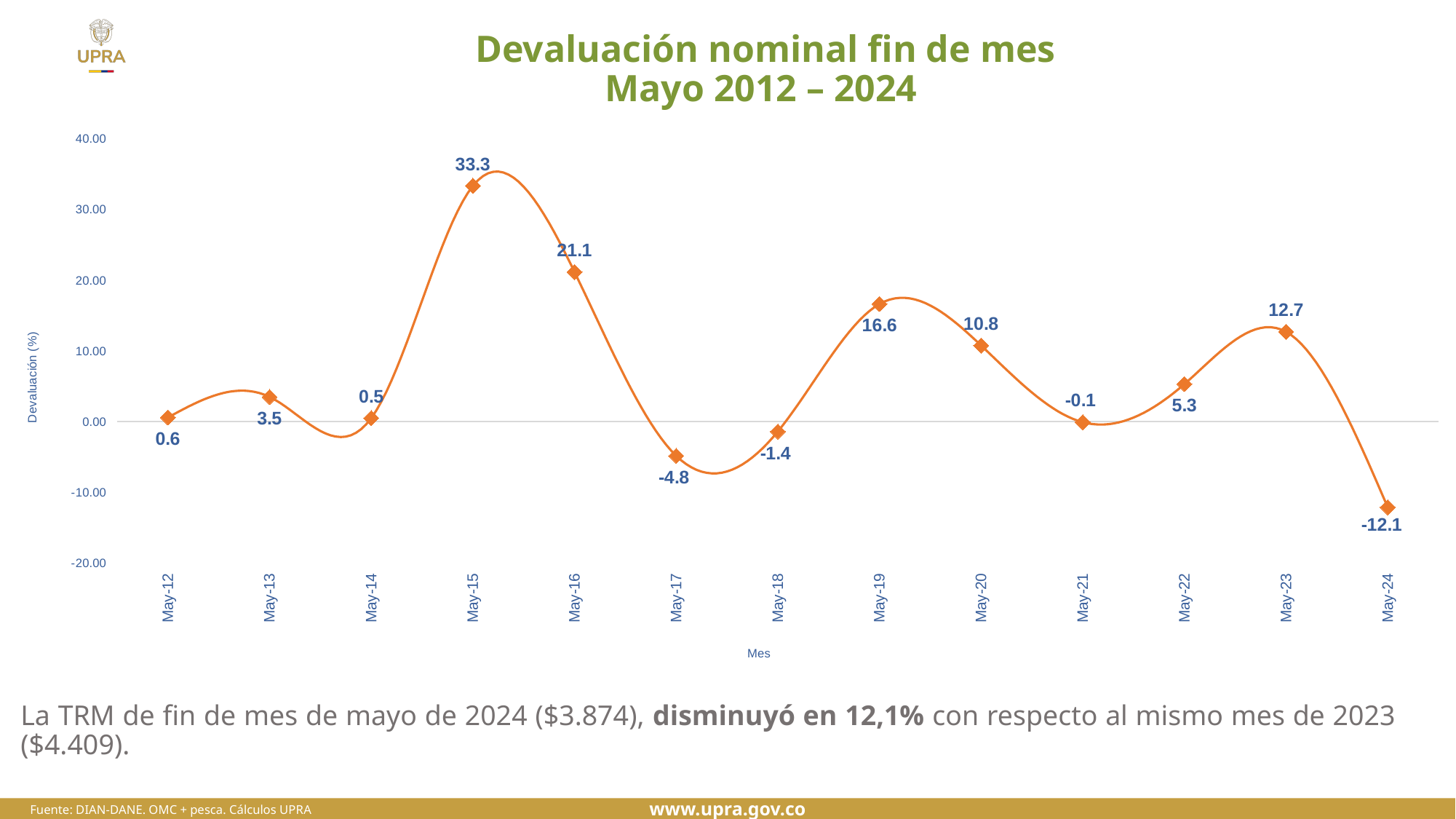
What is the value for May-19? 16.6 Which is larger, the value for May-20 or the value for May-23? May-23 How many data points are plotted on the chart? 13 What is the difference between the values for May-15 and May-16? 12.2 What is the value for May-15? 33.3 What is the label of the y axis? Devaluación (%) What kind of chart is shown on the slide? line chart Which month has the lowest value? May-24 Which month has the highest value? May-15 Is the value for May-16 greater or less than 20.00? greater Do the values rise or fall from May-23 to May-24? fall What is the value for May-24? -12.1